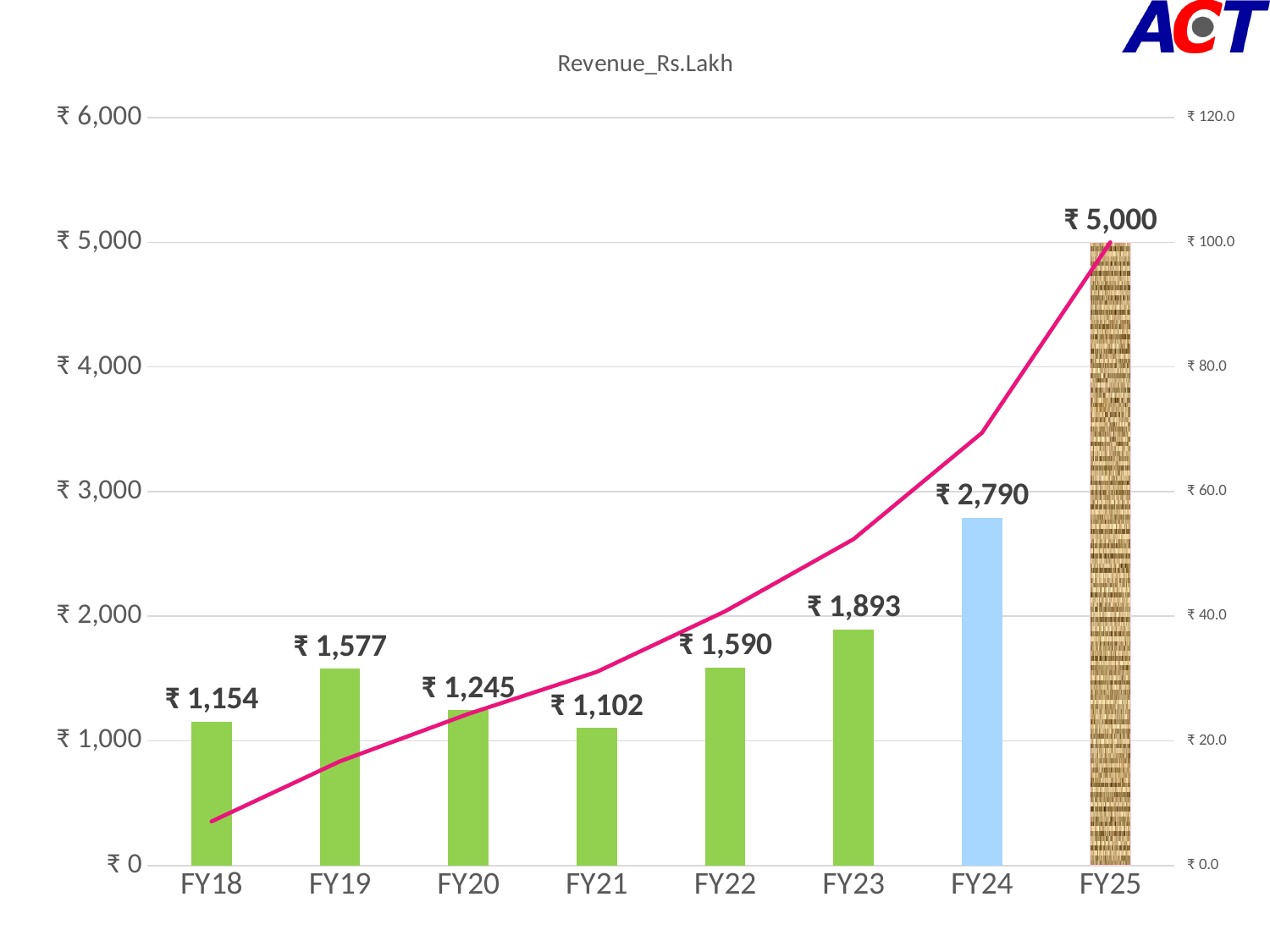
What is the revenue value shown for FY24? ₹ 2,790 What is the revenue value shown for FY21? ₹ 1,102 What is the difference between the revenue for FY25 and FY24? ₹ 2,210 Which fiscal year has the highest revenue bar? FY25 Which is larger, the revenue for FY20 or FY22? FY22 What kind of chart is used to show the revenue values for each fiscal year? bar chart What is the revenue value shown for FY19? ₹ 1,577 Does the pink line rise or fall from FY18 to FY25? rise How many fiscal years are shown on the x axis? 8 What is the difference between the revenue for FY19 and FY18? ₹ 423 Is the revenue for FY23 greater or less than ₹ 2,000? less Which fiscal year has the lowest revenue bar? FY21